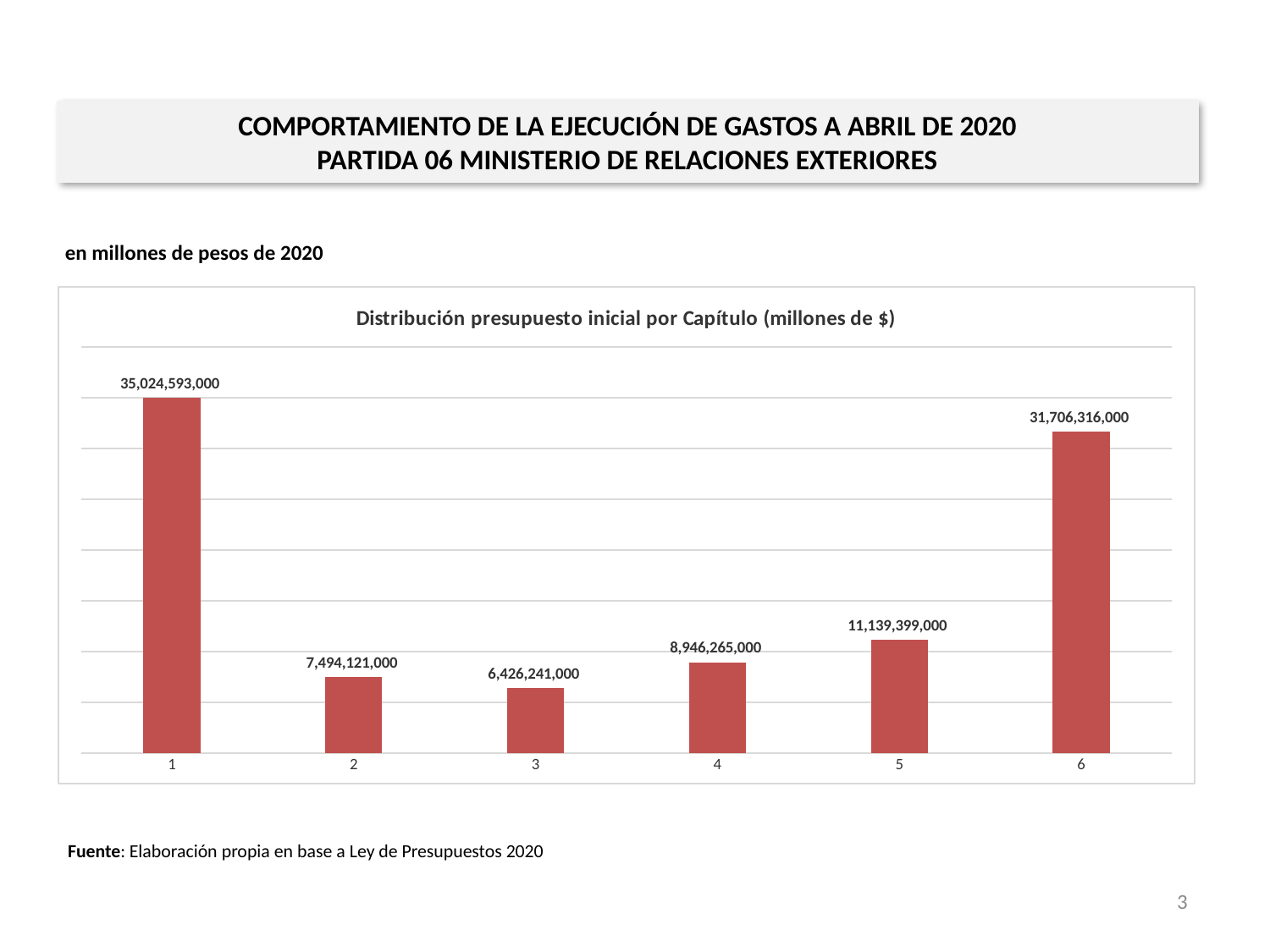
Which category has the highest value? 1 What is the value for category 1? 35,024,593,000 What is the difference between the values for category 1 and category 6? 3,318,277,000 What is the value for category 6? 31,706,316,000 What is the value for category 5? 11,139,399,000 What is the title of the chart? Distribución presupuesto inicial por Capítulo (millones de $) How many categories are shown on the x axis? 6 What is the difference between the values for category 5 and category 4? 2,193,134,000 What is the value for category 3? 6,426,241,000 Which category has the lowest value? 3 What kind of chart is shown? bar chart Which is larger, the value for category 2 or category 4? 4